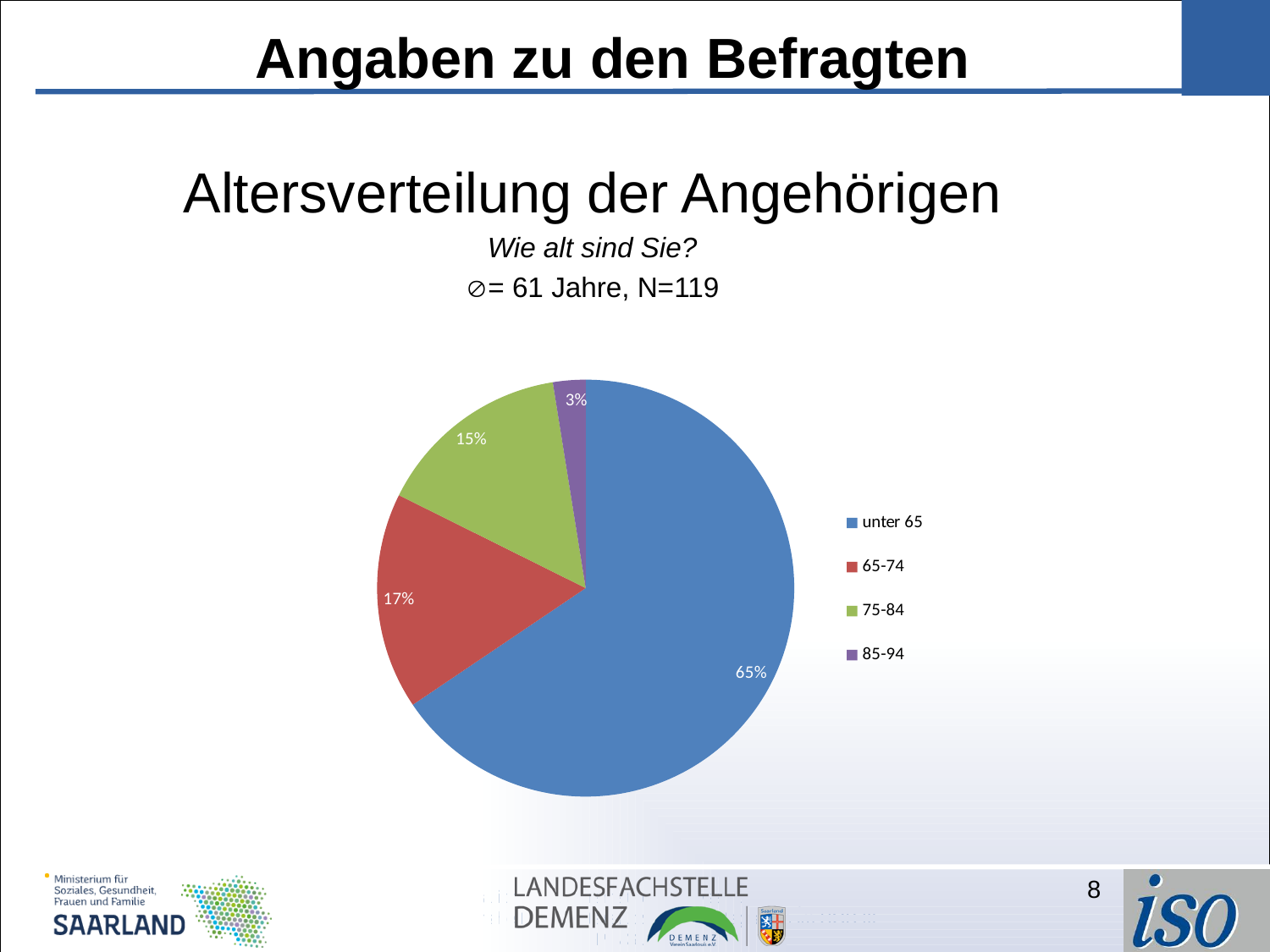
What type of chart is shown on the slide? pie chart What percentage is shown for the '85-94' category? 3% What share of the pie does the 'unter 65' slice represent? 65% What is the difference in percentage points between the 'unter 65' and '65-74' slices? 48 Which age category has the largest share of the pie? unter 65 How many categories does the legend list? 4 What is the combined share of the '75-84' and '85-94' slices? 18% What percentage is shown for the '65-74' category? 17% Which age category has the smallest share of the pie? 85-94 What colour is the slice for '75-84'? green What percentage is shown for the '75-84' category? 15% Which slice is larger, '65-74' or '75-84'? 65-74